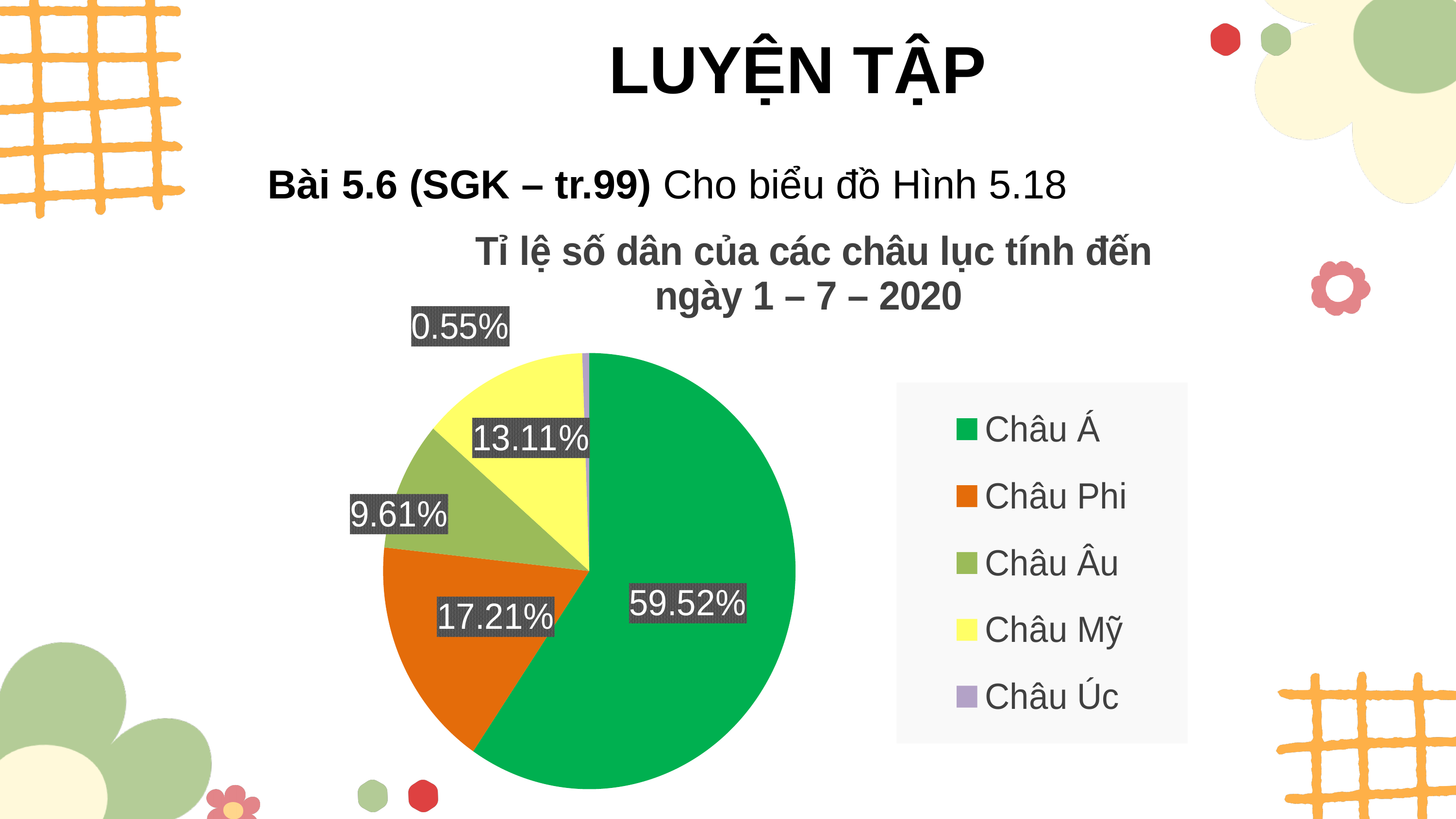
What is the difference between the shares of Châu Phi and Châu Mỹ? 4.10% What is the title of the pie chart? Tỉ lệ số dân của các châu lục tính đến ngày 1 – 7 – 2020 What percentage of the pie chart is Châu Phi? 17.21% Which continent has the largest share of the pie chart? Châu Á Which is larger in the pie chart, Châu Mỹ or Châu Âu? Châu Mỹ Which continent has the smallest share of the pie chart? Châu Úc What percentage of the pie chart is Châu Âu? 9.61% What percentage of the pie chart is Châu Mỹ? 13.11% How many slices does the pie chart have? 5 What kind of chart is shown on the slide? pie chart What percentage of the pie chart is Châu Úc? 0.55% What percentage of the pie chart is Châu Á? 59.52%